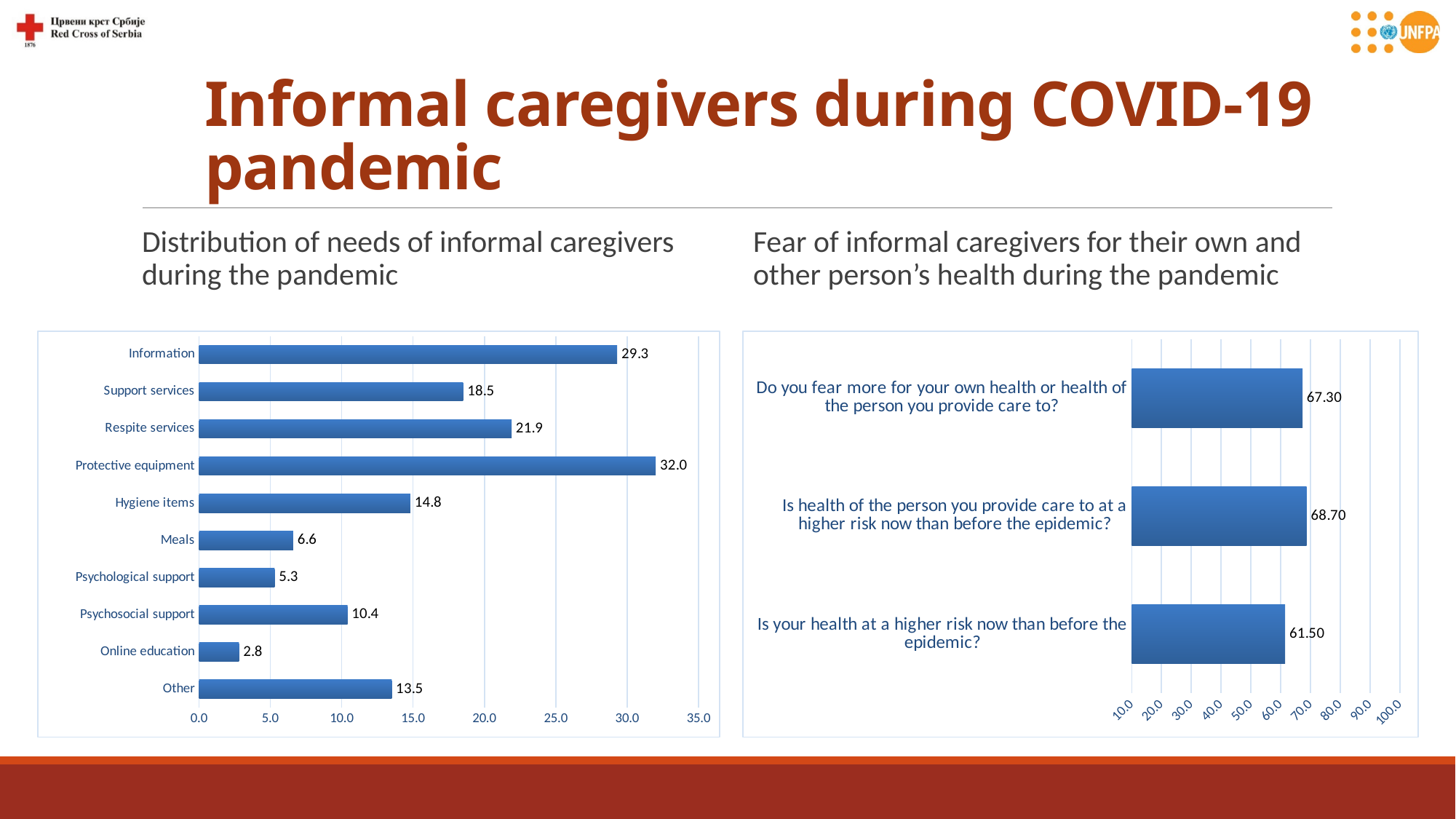
In the left chart (Distribution of needs of informal caregivers during the pandemic), what is the value for Hygiene items? 14.8 In the left chart (Distribution of needs of informal caregivers during the pandemic), which is larger: Respite services or Support services? Respite services In the left chart (Distribution of needs of informal caregivers during the pandemic), how many categories are shown? 10 In the right chart (Fear of informal caregivers for their own and other person's health during the pandemic), what is the value for 'Is your health at a higher risk now than before the epidemic?' 61.50 In the right chart (Fear of informal caregivers for their own and other person's health during the pandemic), how many bars are shown? 3 In the left chart (Distribution of needs of informal caregivers during the pandemic), what is the value for Information? 29.3 In the left chart (Distribution of needs of informal caregivers during the pandemic), which category has the highest value? Protective equipment In the left chart (Distribution of needs of informal caregivers during the pandemic), what is the difference between the values for Protective equipment and Information? 2.7 What kind of chart is the left chart (Distribution of needs of informal caregivers during the pandemic)? Bar chart In the left chart (Distribution of needs of informal caregivers during the pandemic), which category has the lowest value? Online education In the right chart (Fear of informal caregivers for their own and other person's health during the pandemic), what is the difference between the values for 'Is health of the person you provide care to at a higher risk now than before the epidemic?' and 'Is your health at a higher risk now than before the epidemic?' 7.20 In the right chart (Fear of informal caregivers for their own and other person's health during the pandemic), which question has the highest value? Is health of the person you provide care to at a higher risk now than before the epidemic?